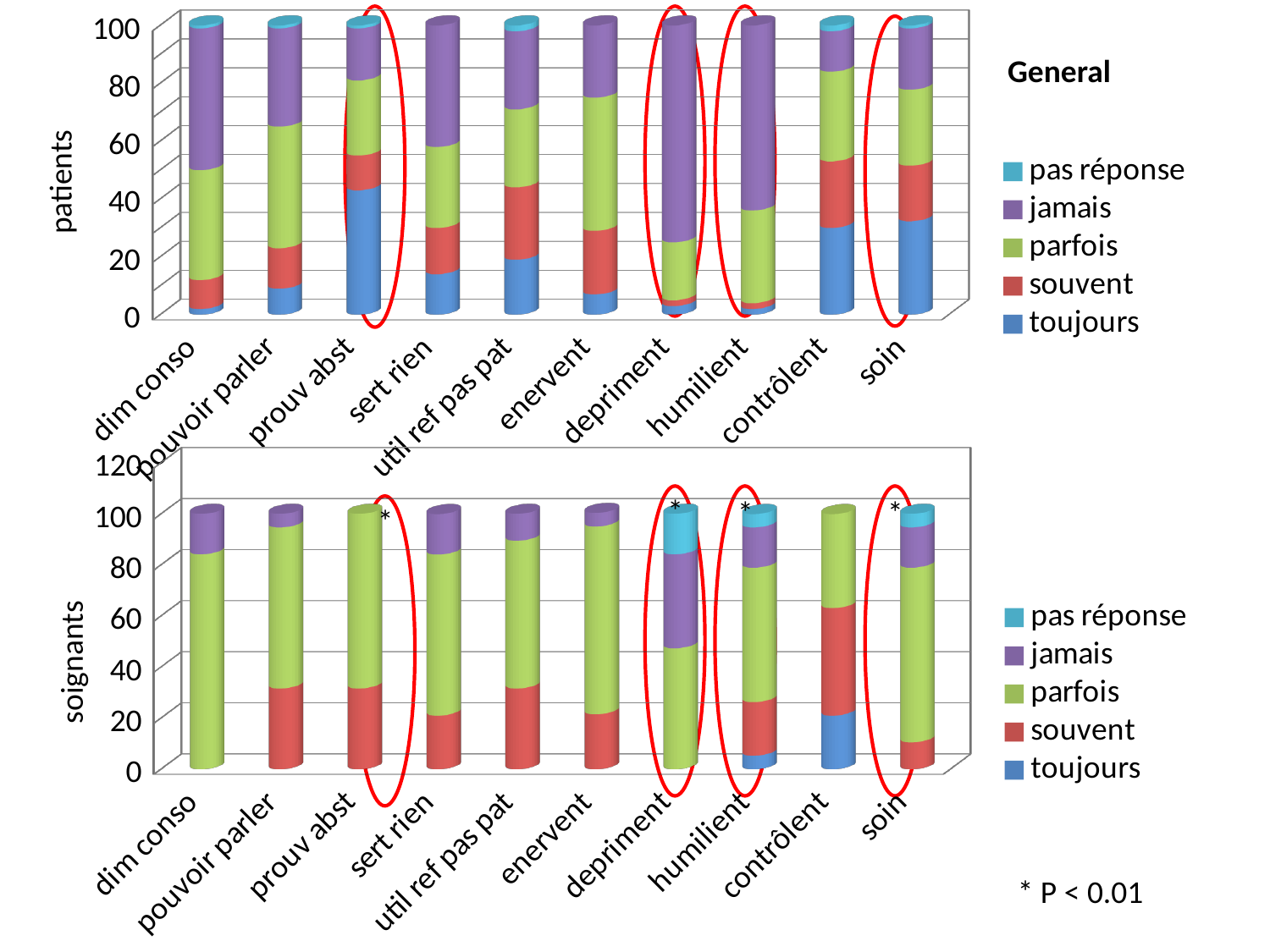
In the top chart labelled "patients", is the "jamais" value for "depriment" greater or less than 60? greater How many categories are shown on the x axis of the bottom chart labelled "soignants"? 10 In the bottom chart labelled "soignants", which has the larger "souvent" value, "contrôlent" or "soin"? contrôlent In the bottom chart labelled "soignants", is the "souvent" value for "soin" greater or less than 20? less In the top chart labelled "patients", is the "toujours" value for "soin" greater or less than 20? greater Which legend entry is shown in green in both charts? parfois How many series does the legend of the top chart labelled "patients" list? 5 What kind of chart is the top chart labelled "patients"? stacked bar chart In the top chart labelled "patients", which has the larger "toujours" value, "prouv abst" or "dim conso"? prouv abst What is the title shown above the legend of the top chart? General In the top chart labelled "patients", which category has the largest "jamais" segment? depriment